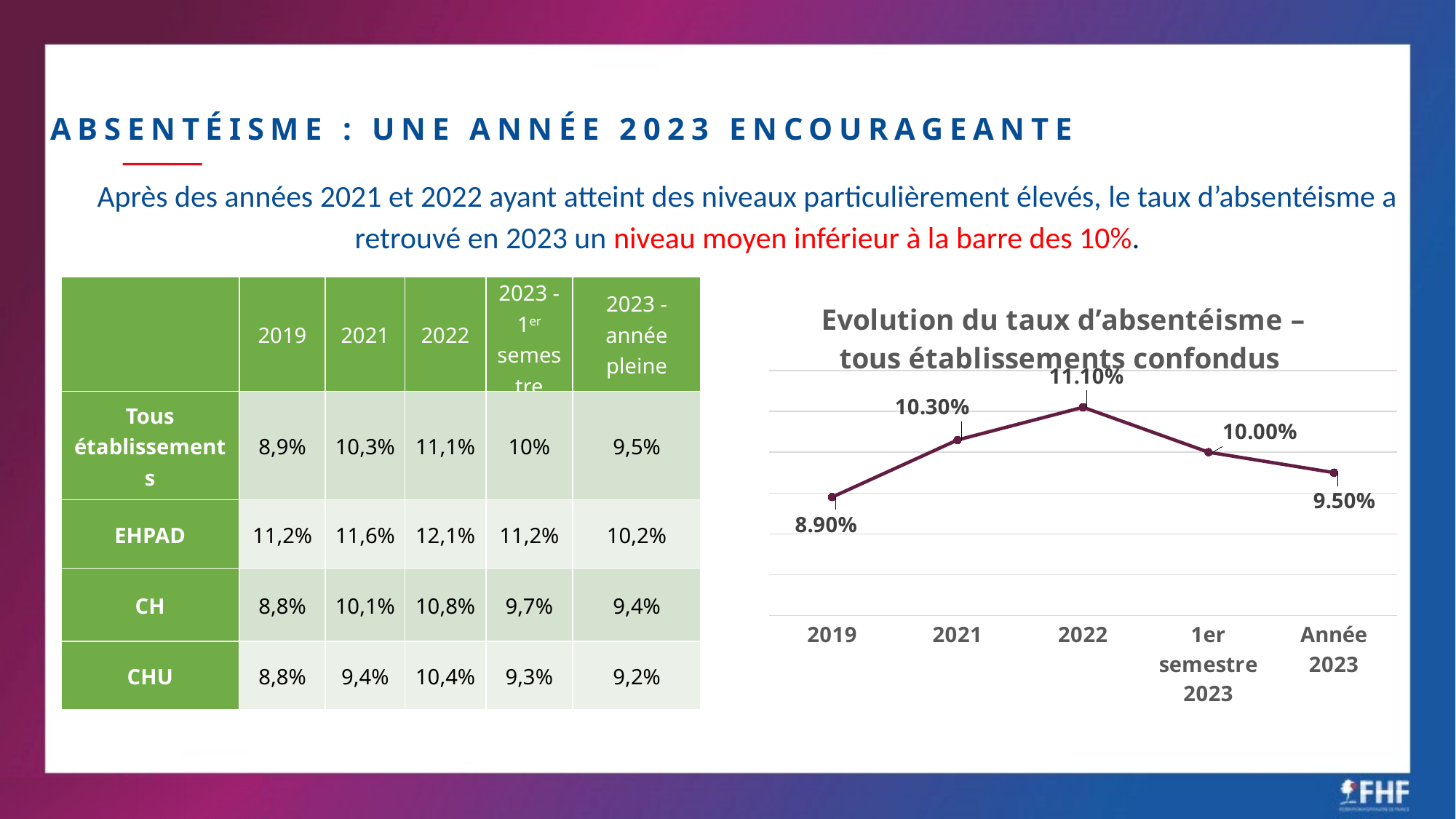
Which point on the chart has the lowest value? 2019 What is the difference between the values for 2022 and 2019 in the chart? 2.20% Which point on the chart has the highest value? 2022 What type of chart is shown on the slide? line chart What is the value plotted for 2019 in the chart? 8.90% Which is larger in the chart, the value for 2021 or the value for Année 2023? 2021 What is the value plotted for Année 2023 in the chart? 9.50% What is the value plotted for 2022 in the chart? 11.10% What is the value plotted for 1er semestre 2023 in the chart? 10.00% What is the title of the chart? Evolution du taux d'absentéisme – tous établissements confondus What is the value plotted for 2021 in the chart? 10.30% How many data points are plotted on the chart? 5